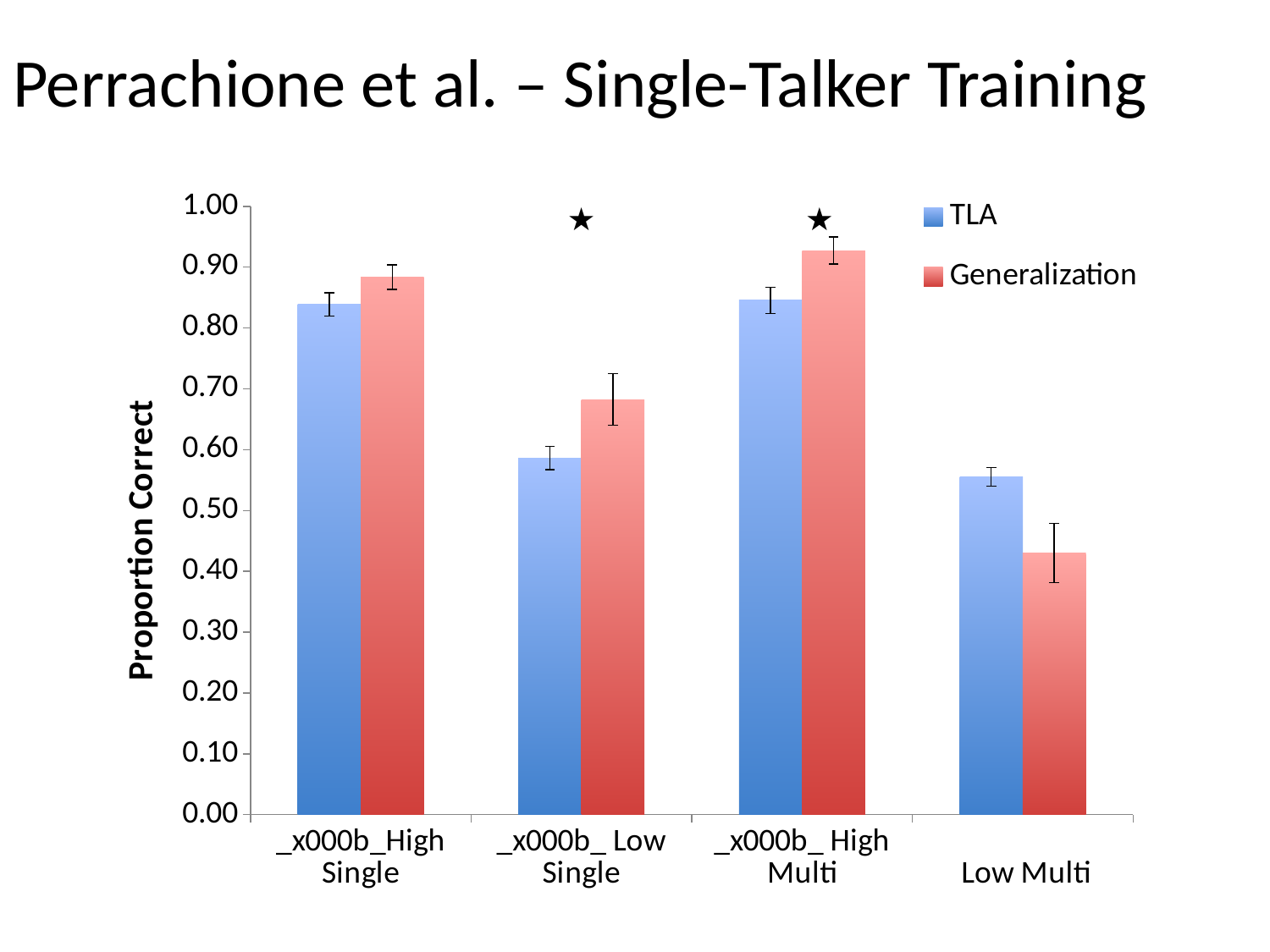
How many categories are shown on the x axis? 4 What is the title of the y axis? Proportion Correct What kind of chart is shown on the slide? bar chart Is the Generalization value for High Multi greater or less than 0.90? greater For High Multi, which is larger: the TLA value or the Generalization value? Generalization Which category has the lowest Generalization value? Low Multi How many series does the legend list? 2 For Low Multi, which is larger: the TLA value or the Generalization value? TLA Is the Generalization value for Low Multi greater or less than 0.50? less Is the TLA value for High Single greater or less than 0.80? greater Which category has the highest Generalization value? High Multi